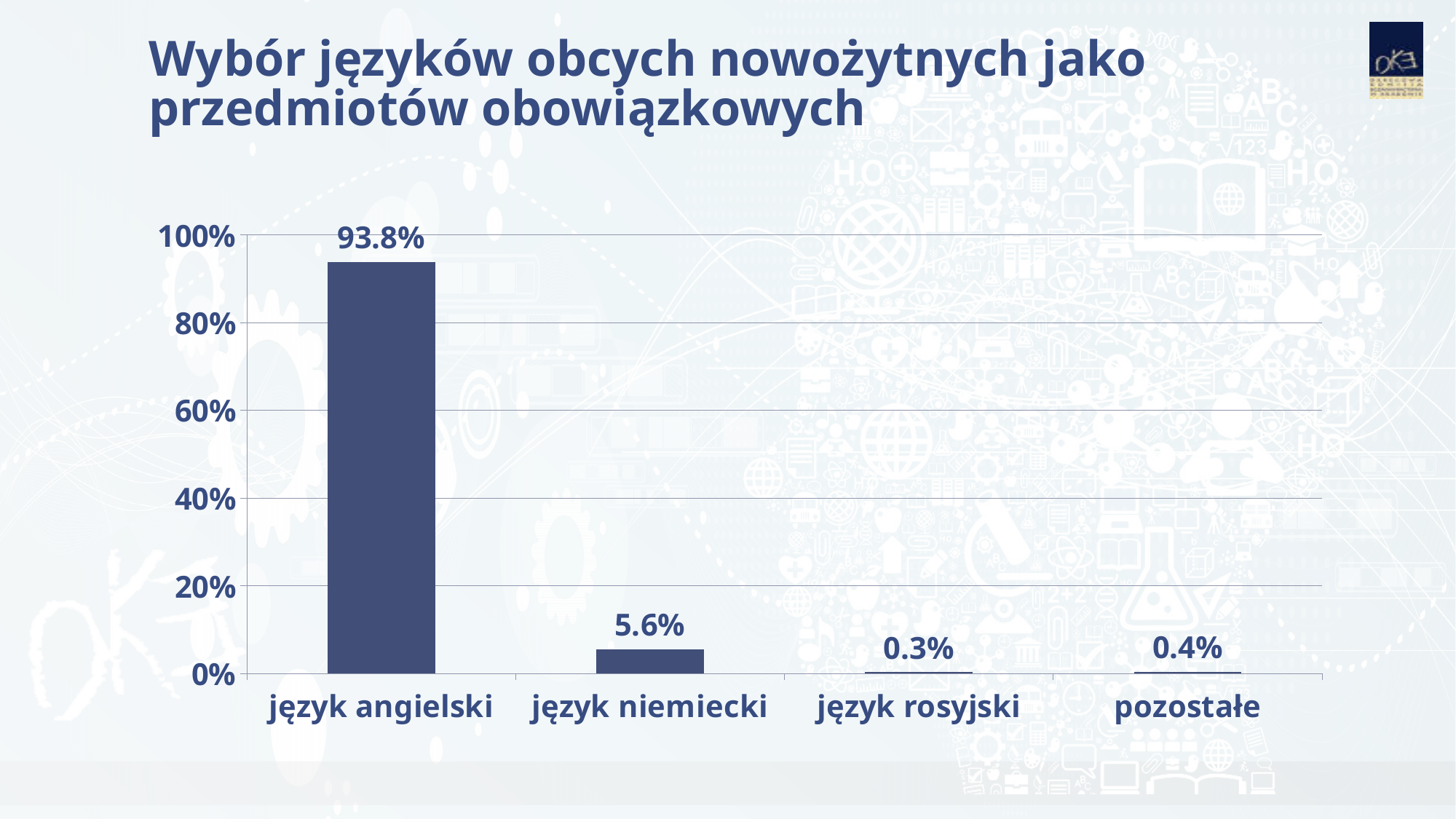
What is the value for język niemiecki? 5.6% What is the value for język angielski? 93.8% Which category has the highest value? język angielski Which is larger, the value for język niemiecki or the value for pozostałe? język niemiecki What is the value for pozostałe? 0.4% How many categories are shown on the x axis? 4 What is the title of the chart on the slide? Wybór języków obcych nowożytnych jako przedmiotów obowiązkowych What kind of chart is shown on the slide? bar chart Which category has the lowest value? język rosyjski Is the value for język angielski greater or less than 80%? greater What is the value for język rosyjski? 0.3% What is the difference between the values for język angielski and język niemiecki? 88.2%